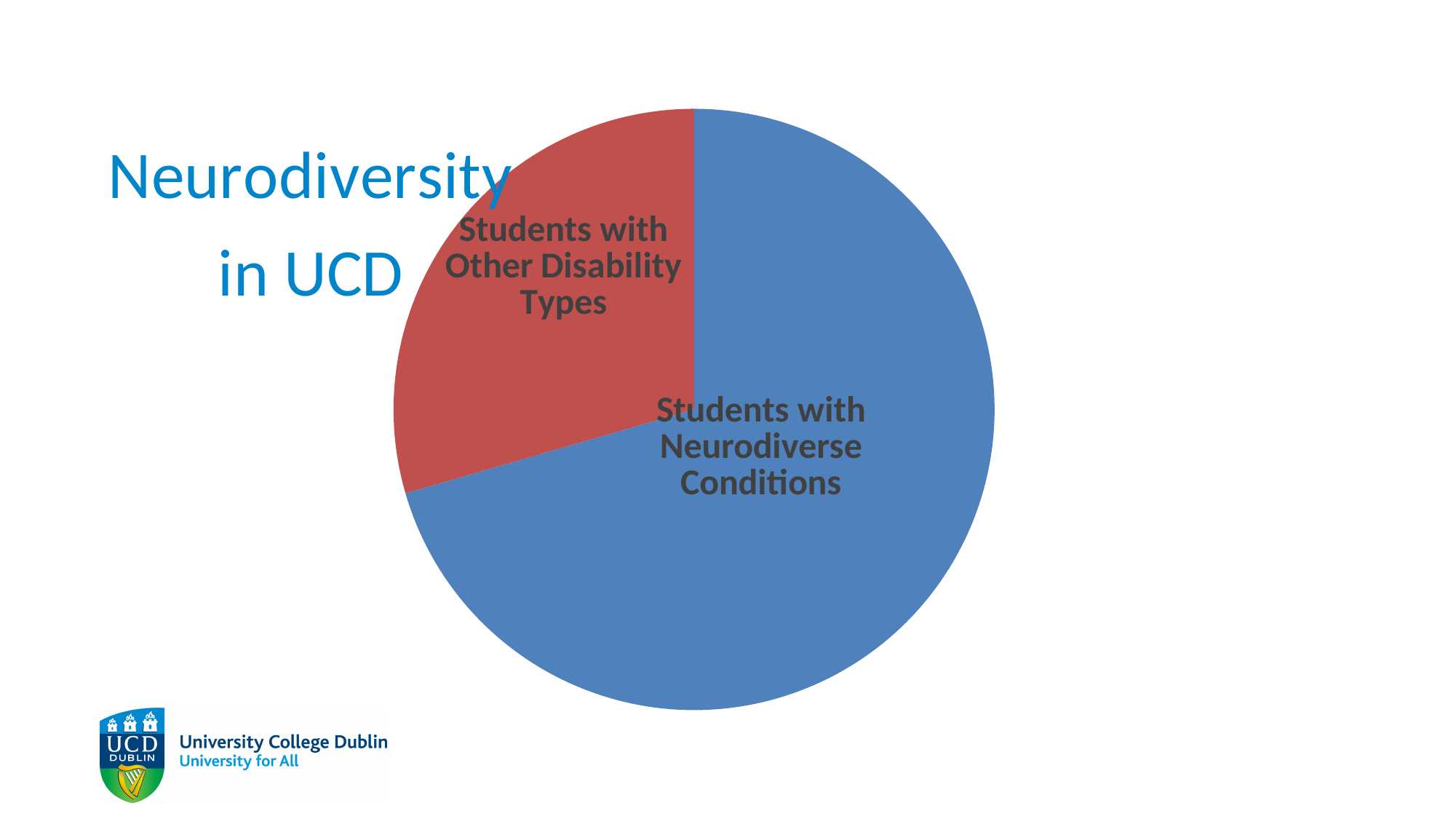
How many slices does the pie chart have? 2 What colour is the slice for Students with Neurodiverse Conditions? Blue What kind of chart is shown on the slide? Pie chart What colour is the slice for Students with Other Disability Types? Red Which slice of the pie chart is the largest? Students with Neurodiverse Conditions Which is larger: the slice for Students with Neurodiverse Conditions or the slice for Students with Other Disability Types? Students with Neurodiverse Conditions Which slice of the pie chart is the smallest? Students with Other Disability Types